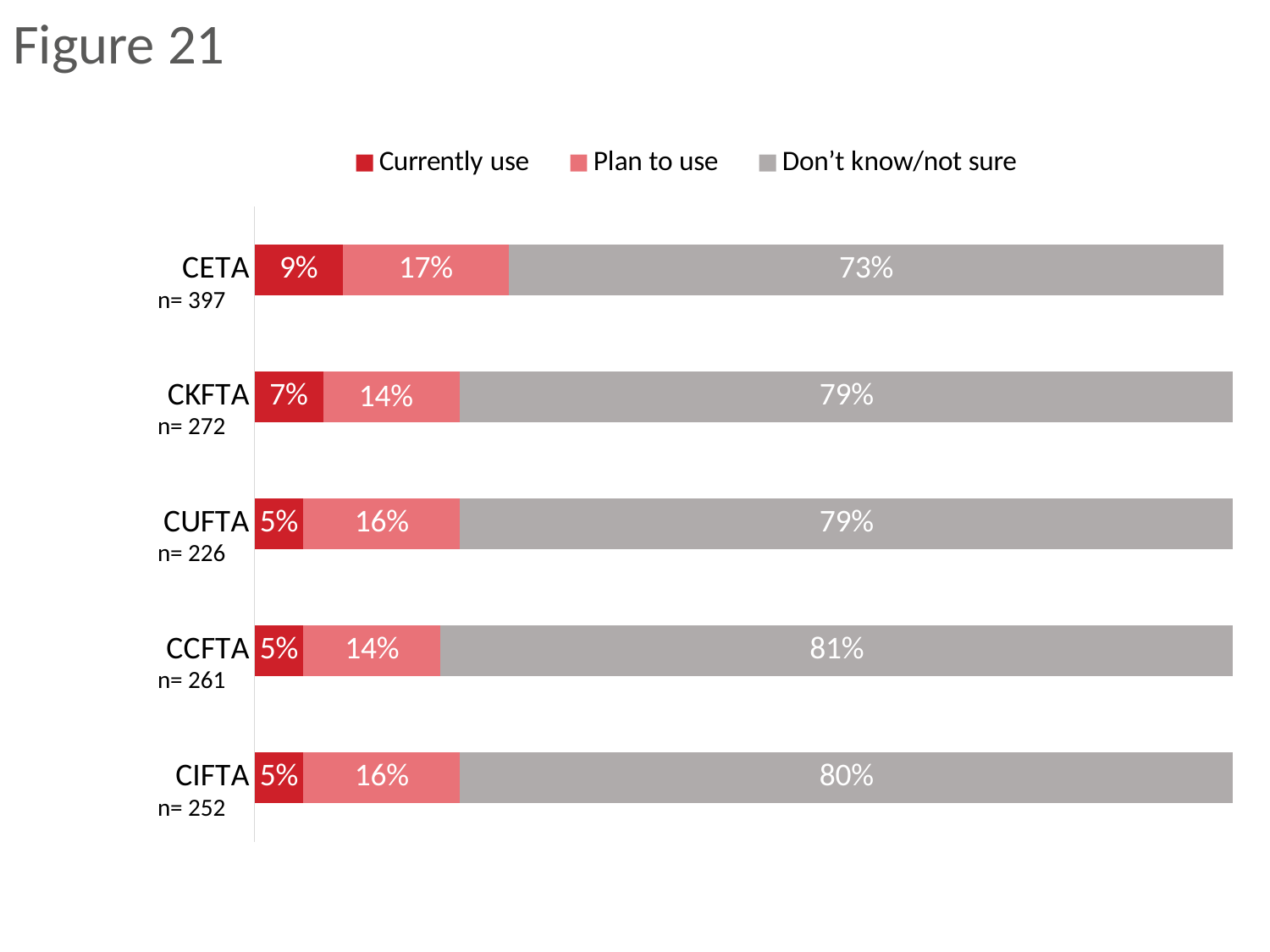
Is the 'Currently use' value larger for CKFTA or for CIFTA? CKFTA Which agreement has the highest 'Currently use' percentage? CETA Which agreement has the lowest 'Don't know/not sure' percentage? CETA What kind of chart is shown on the slide? Stacked bar chart What is the sample size (n) shown for CUFTA? 226 Which series is shown in grey in the legend? Don't know/not sure What is the 'Don't know/not sure' value for CCFTA? 81% How many series does the legend list? 3 What is the difference between the 'Plan to use' values for CETA and CKFTA? 3% How many agreements are shown on the chart? 5 What percentage of CETA respondents currently use the agreement? 9% What is the 'Plan to use' value for CUFTA? 16%